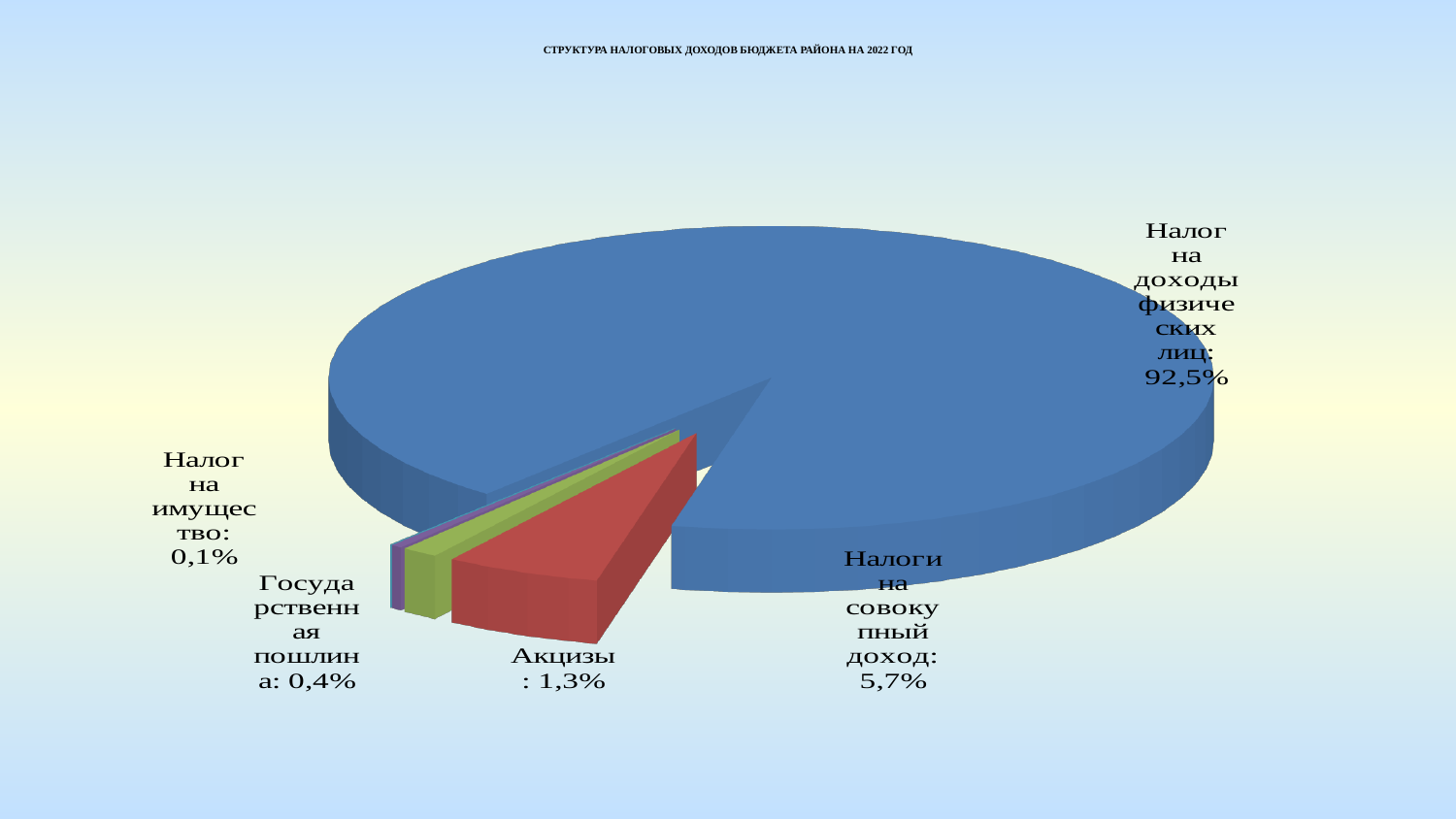
What is the value shown for Акцизы? 1,3% What is the value shown for Государственная пошлина? 0,4% What share of the pie is Налог на доходы физических лиц? 92,5% Which category has the largest share of the pie? Налог на доходы физических лиц What is the title of the chart? СТРУКТУРА НАЛОГОВЫХ ДОХОДОВ БЮДЖЕТА РАЙОНА НА 2022 ГОД What is the value shown for Налог на имущество? 0,1% Which category has the smallest share of the pie? Налог на имущество How many slices does the pie chart have? 5 What is the value shown for Налоги на совокупный доход? 5,7% Which is larger, the share for Акцизы or the share for Государственная пошлина? Акцизы What is the difference between the shares of Налоги на совокупный доход and Акцизы? 4,4% What type of chart is shown on the slide? Pie chart